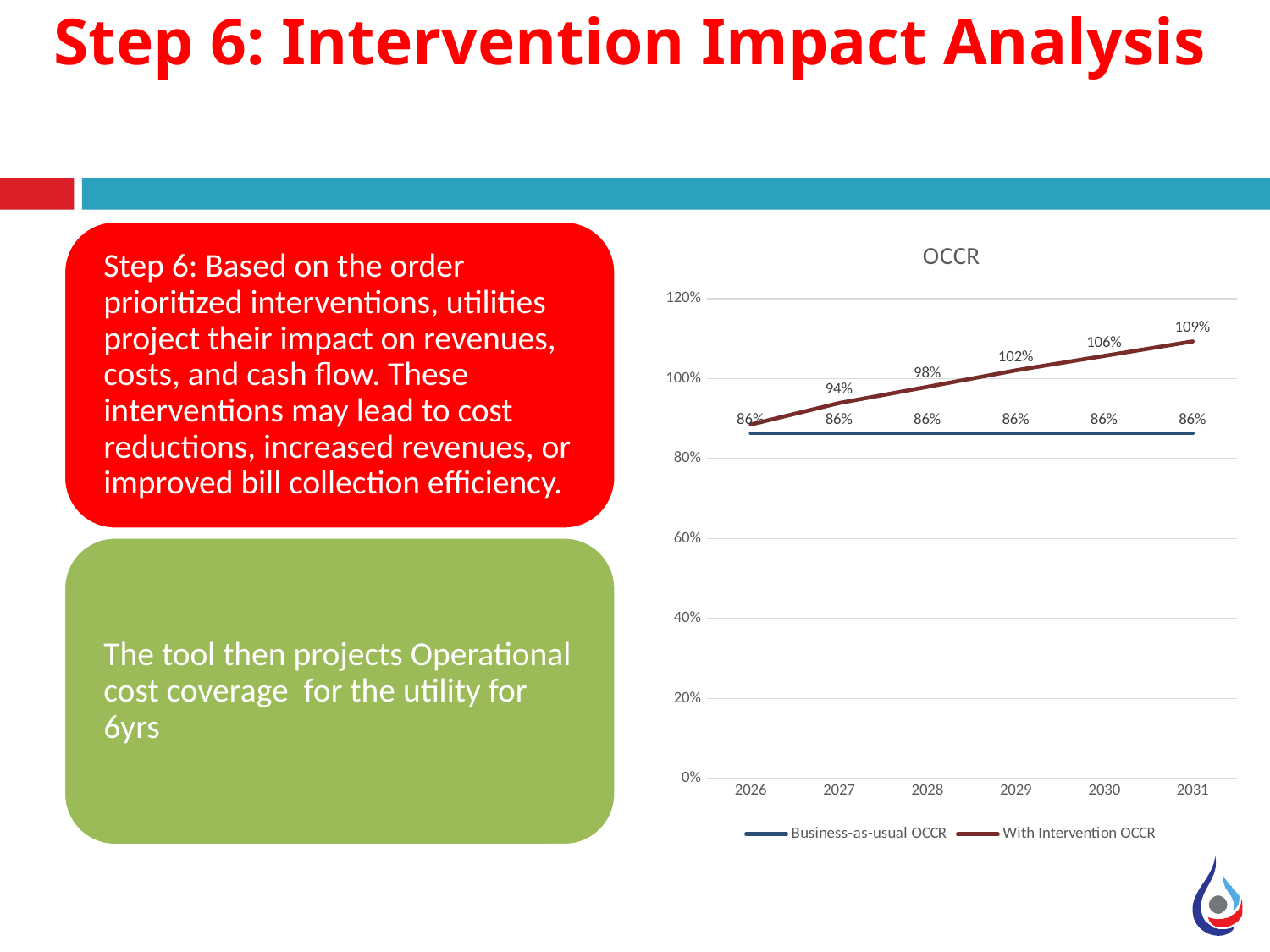
Does the With Intervention OCCR rise or fall from 2026 to 2031? rise What is the difference between the With Intervention OCCR and the Business-as-usual OCCR in 2030? 20% Which is larger in 2029: the With Intervention OCCR or the Business-as-usual OCCR? With Intervention OCCR Is the With Intervention OCCR value for 2029 greater or less than 100%? greater How many years are shown on the x axis of the chart? 6 What is the With Intervention OCCR value for 2028? 98% What is the Business-as-usual OCCR value for 2028? 86% How many series does the chart legend list? 2 In which year is the With Intervention OCCR highest? 2031 What is the title of the chart? OCCR What kind of chart is shown on the slide? line chart What is the With Intervention OCCR value for 2031? 109%